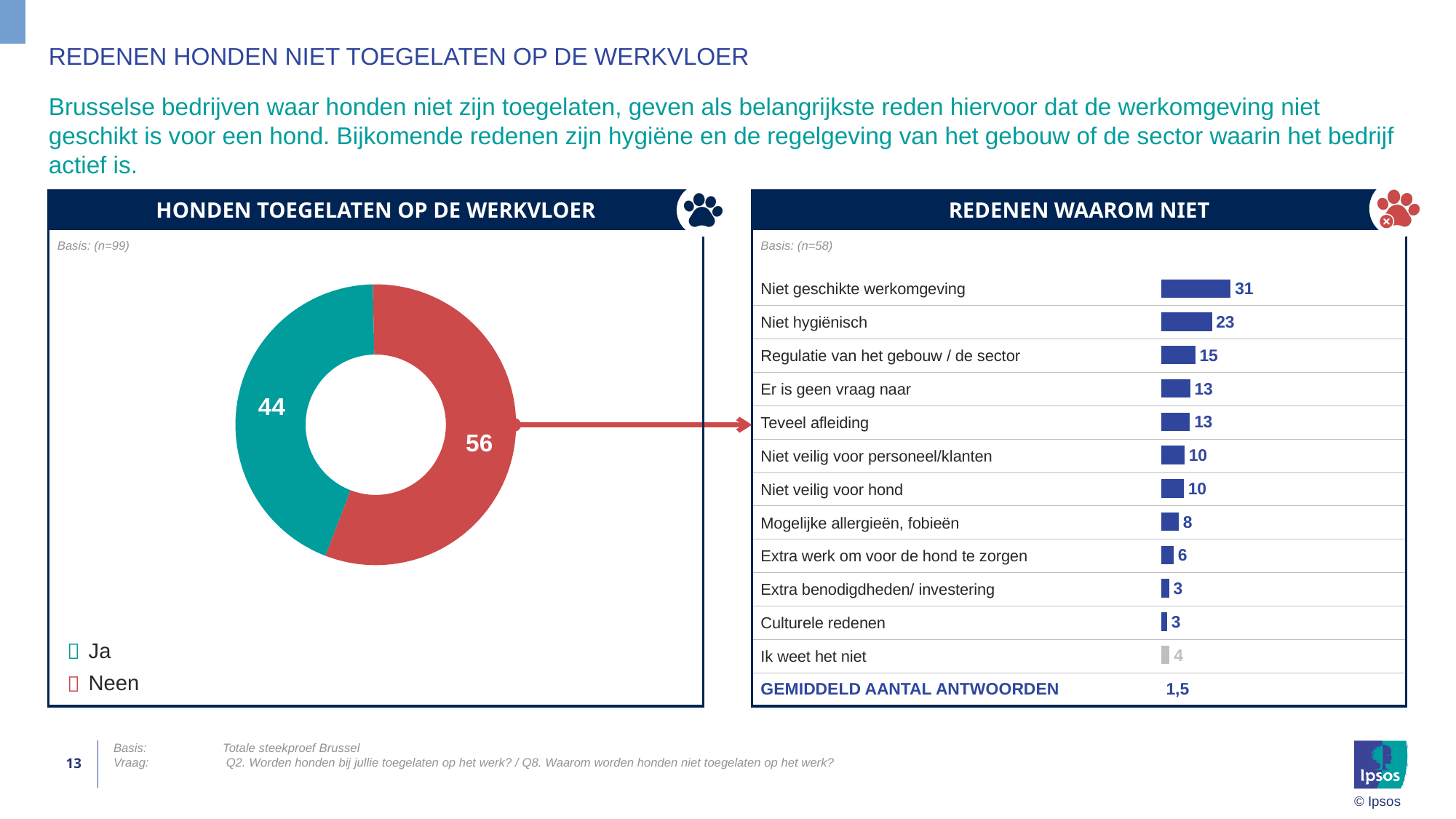
In the 'REDENEN WAAROM NIET' chart, what is the value for Regulatie van het gebouw / de sector? 15 In the 'REDENEN WAAROM NIET' chart, how many reasons (categories) are listed, including Ik weet het niet? 12 In the 'REDENEN WAAROM NIET' chart, what is the difference between Niet geschikte werkomgeving and Niet hygiënisch? 8 In the 'HONDEN TOEGELATEN OP DE WERKVLOER' chart, what is the value for Ja? 44 In the 'REDENEN WAAROM NIET' chart, which reason has the highest value? Niet geschikte werkomgeving In the 'HONDEN TOEGELATEN OP DE WERKVLOER' chart, what is the value for Neen? 56 In the 'REDENEN WAAROM NIET' chart, which is larger, Mogelijke allergieën, fobieën or Extra werk om voor de hond te zorgen? Mogelijke allergieën, fobieën In the 'HONDEN TOEGELATEN OP DE WERKVLOER' chart, what is the difference between Neen and Ja? 12 In the 'HONDEN TOEGELATEN OP DE WERKVLOER' chart, what kind of chart is shown? Donut (pie) chart In the 'HONDEN TOEGELATEN OP DE WERKVLOER' chart, which is larger, Ja or Neen? Neen In the 'REDENEN WAAROM NIET' chart, what is the value for Niet hygiënisch? 23 In the 'REDENEN WAAROM NIET' chart, what kind of chart is shown? Bar chart